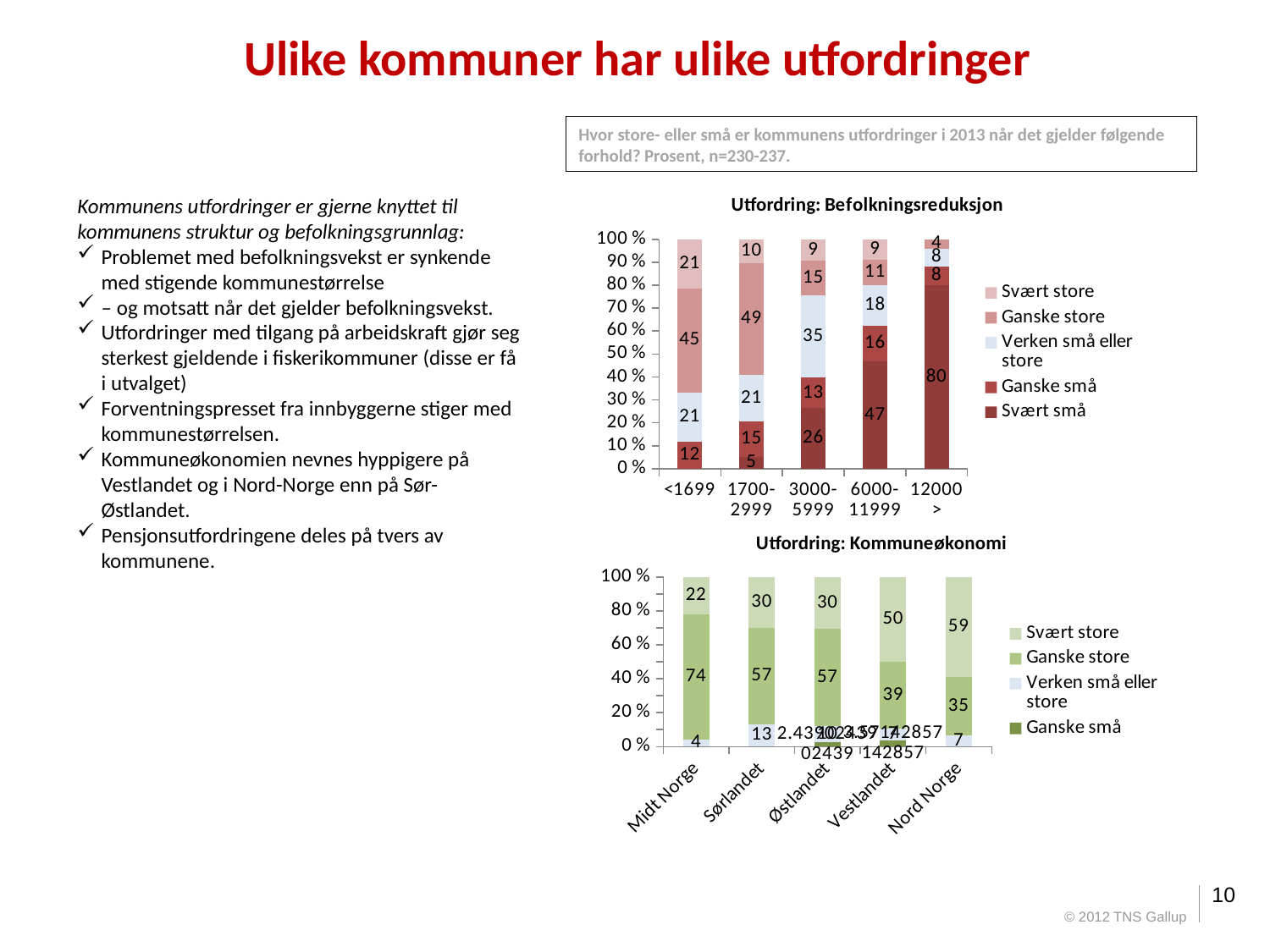
In the chart titled 'Utfordring: Kommuneøkonomi', what is the value of 'Svært store' for 'Nord Norge'? 59 What kind of chart is 'Utfordring: Kommuneøkonomi'? Stacked bar chart In the chart titled 'Utfordring: Befolkningsreduksjon', what is the value of 'Ganske store' for the '1700-2999' category? 49 In the chart titled 'Utfordring: Kommuneøkonomi', what is the value of 'Ganske store' for 'Midt Norge'? 74 In the chart titled 'Utfordring: Befolkningsreduksjon', what is the difference between the 'Svært små' values for '6000-11999' and '3000-5999'? 21 In the chart titled 'Utfordring: Befolkningsreduksjon', what is the value of 'Svært små' for the '12000 >' category? 80 In the chart titled 'Utfordring: Befolkningsreduksjon', which category has the highest 'Svært små' value? 12000 > In the chart titled 'Utfordring: Kommuneøkonomi', is the 'Ganske store' value larger for 'Sørlandet' or 'Nord Norge'? Sørlandet In the chart titled 'Utfordring: Befolkningsreduksjon', how many series does the legend list? 5 In the chart titled 'Utfordring: Kommuneøkonomi', which region has the highest 'Svært store' value? Nord Norge In the chart titled 'Utfordring: Befolkningsreduksjon', does the 'Svært små' value rise or fall as the x axis moves from '<1699' to '12000 >'? rise